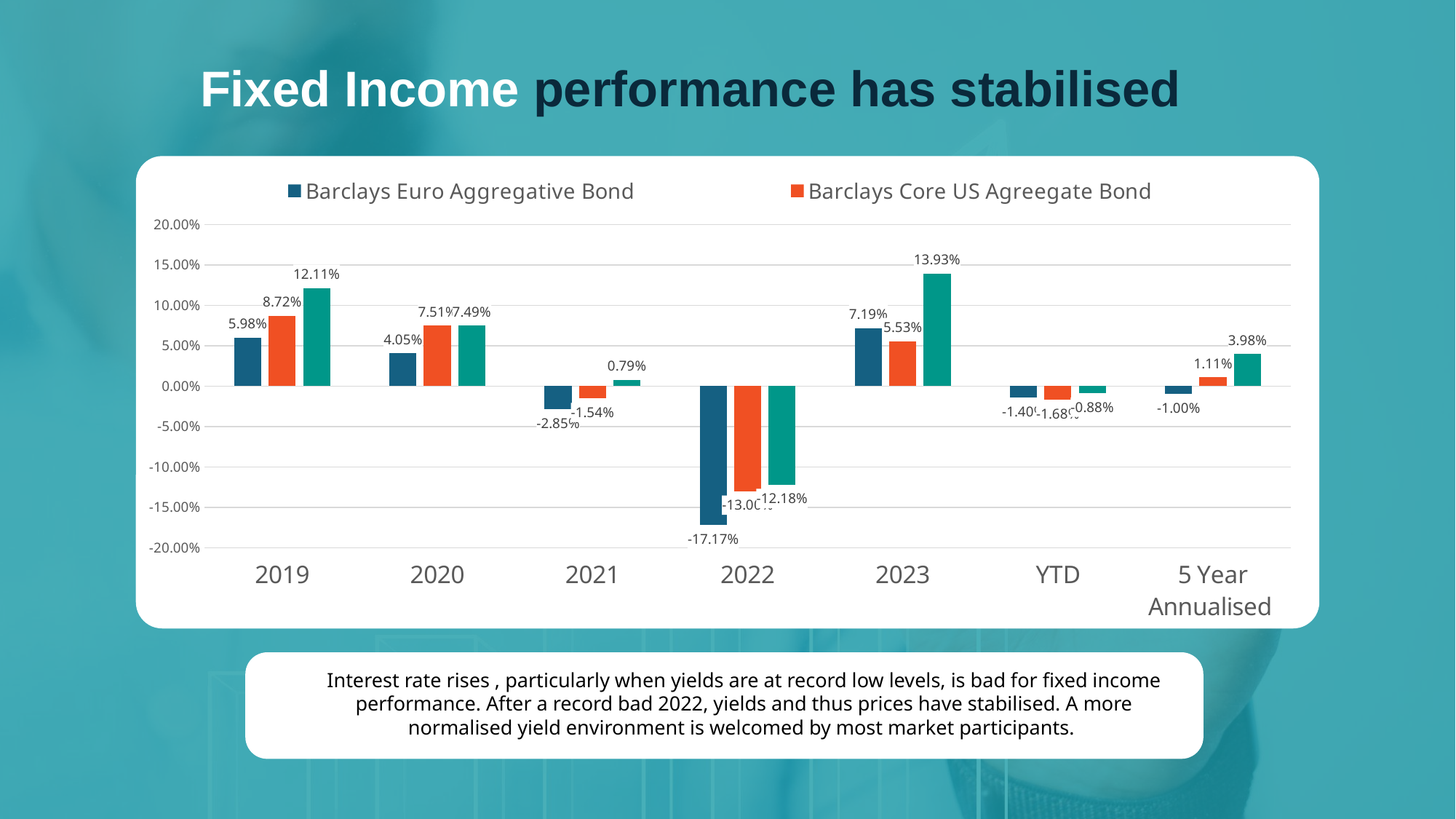
In which category does Barclays Euro Aggregative Bond have its lowest value? 2022 What is the value for Barclays Core US Agreegate Bond in 2023? 5.53% How many categories are shown on the x axis of the chart? 7 In 2019, how much higher is Barclays Core US Agreegate Bond than Barclays Euro Aggregative Bond? 2.74 percentage points What is the value for Barclays Euro Aggregative Bond in 2019? 5.98% What is the 5 Year Annualised value for Barclays Core US Agreegate Bond? 1.11% What is the value for Barclays Core US Agreegate Bond in 2020? 7.51% What is the value for Barclays Euro Aggregative Bond in 2022? -17.17% How many series does the chart's legend list? 2 In which category does Barclays Core US Agreegate Bond have its highest value? 2019 In 2023, which is larger: Barclays Euro Aggregative Bond or Barclays Core US Agreegate Bond? Barclays Euro Aggregative Bond What kind of chart is shown on the slide? Bar chart